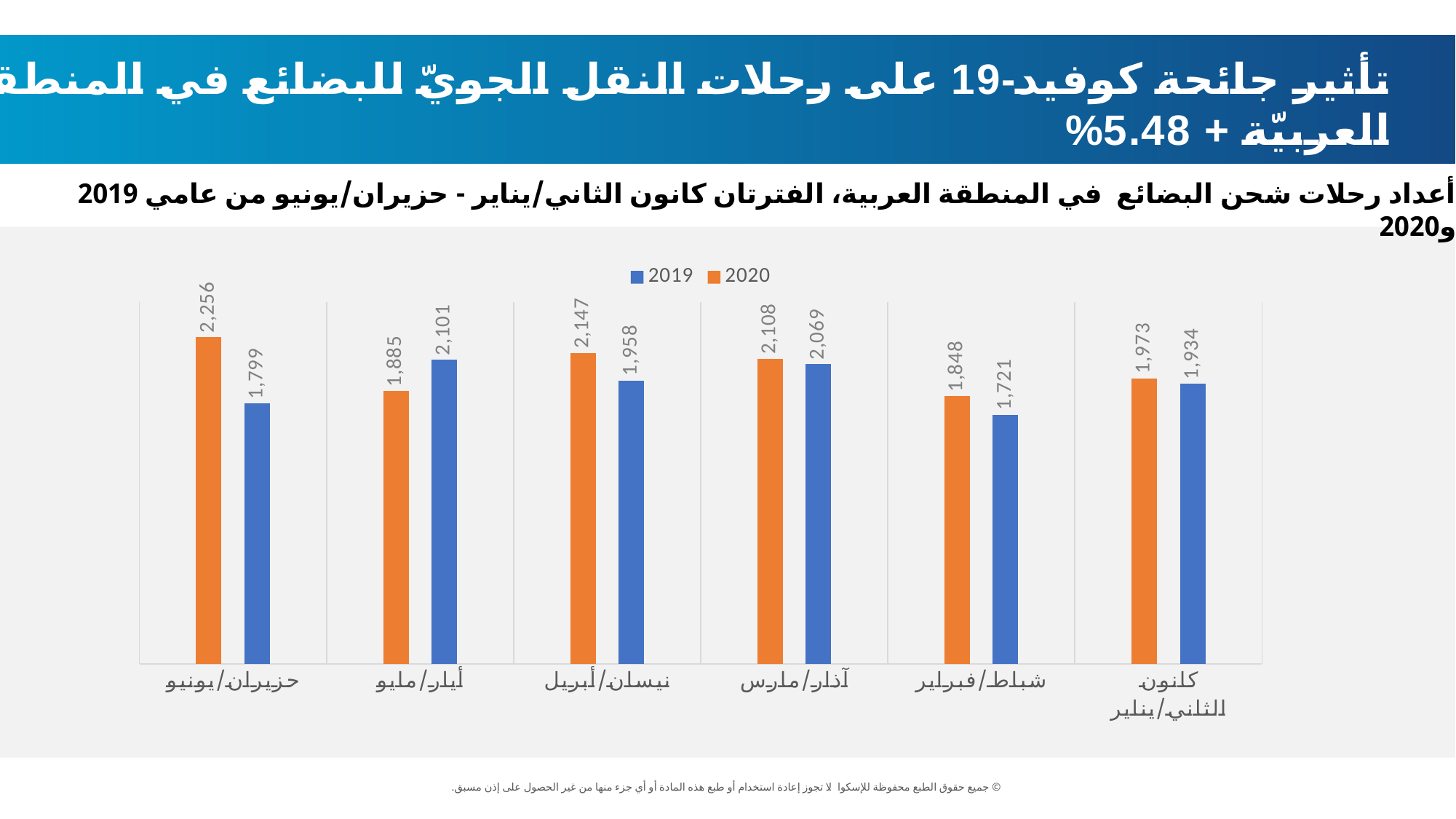
What is the difference between the 2020 and 2019 values for نيسان/أبريل (April)? 189 What is the 2020 value for شباط/فبراير (February)? 1,848 Which month has the lowest 2019 value? شباط/فبراير Which month has the highest 2020 value? حزيران/يونيو What is the 2019 value for كانون الثاني/يناير (January)? 1,934 For أيار/مايو (May), which series is larger, 2019 or 2020? 2019 Which colour represents the 2020 series in the legend? Orange How many series does the legend list? 2 What is the 2020 value for حزيران/يونيو (June)? 2,256 How many months are shown on the x axis? 6 What is the 2019 value for أيار/مايو (May)? 2,101 What kind of chart is shown on the slide? Bar chart